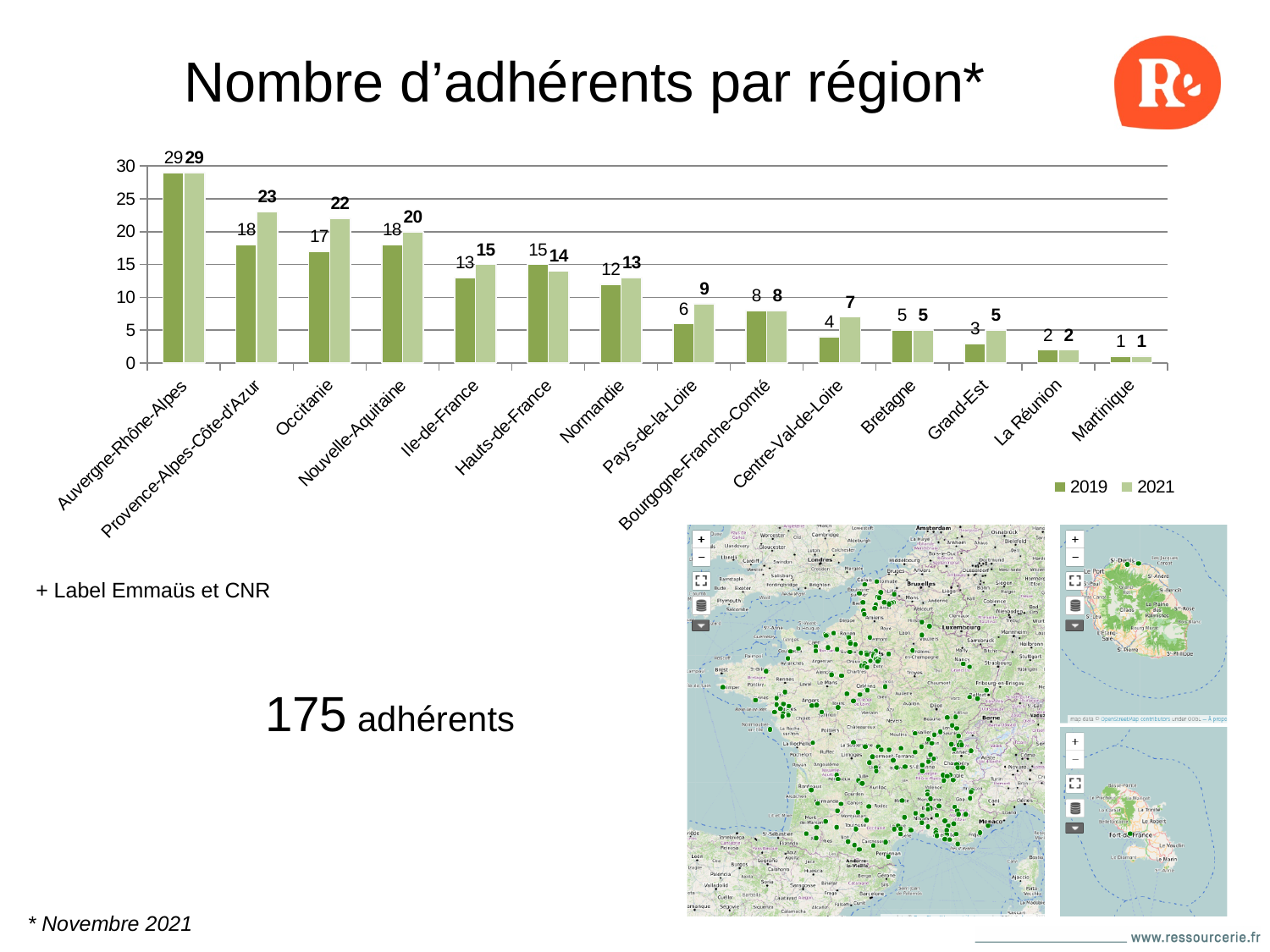
What is the 2021 value for Centre-Val-de-Loire? 7 Do the 2021 values generally rise or fall from left to right along the x axis? fall How many regions are shown on the x axis? 14 Which region has the lowest 2019 value? Martinique What is the 2021 value for Provence-Alpes-Côte-d'Azur? 23 What is the difference between the 2021 and 2019 values for Pays-de-la-Loire? 3 How many series does the legend list? 2 What is the 2019 value for Occitanie? 17 What kind of chart is shown on the slide? bar chart What is the title of the chart? Nombre d'adhérents par région* Which is larger for Hauts-de-France, the 2019 value or the 2021 value? 2019 Which region has the highest 2021 value? Auvergne-Rhône-Alpes